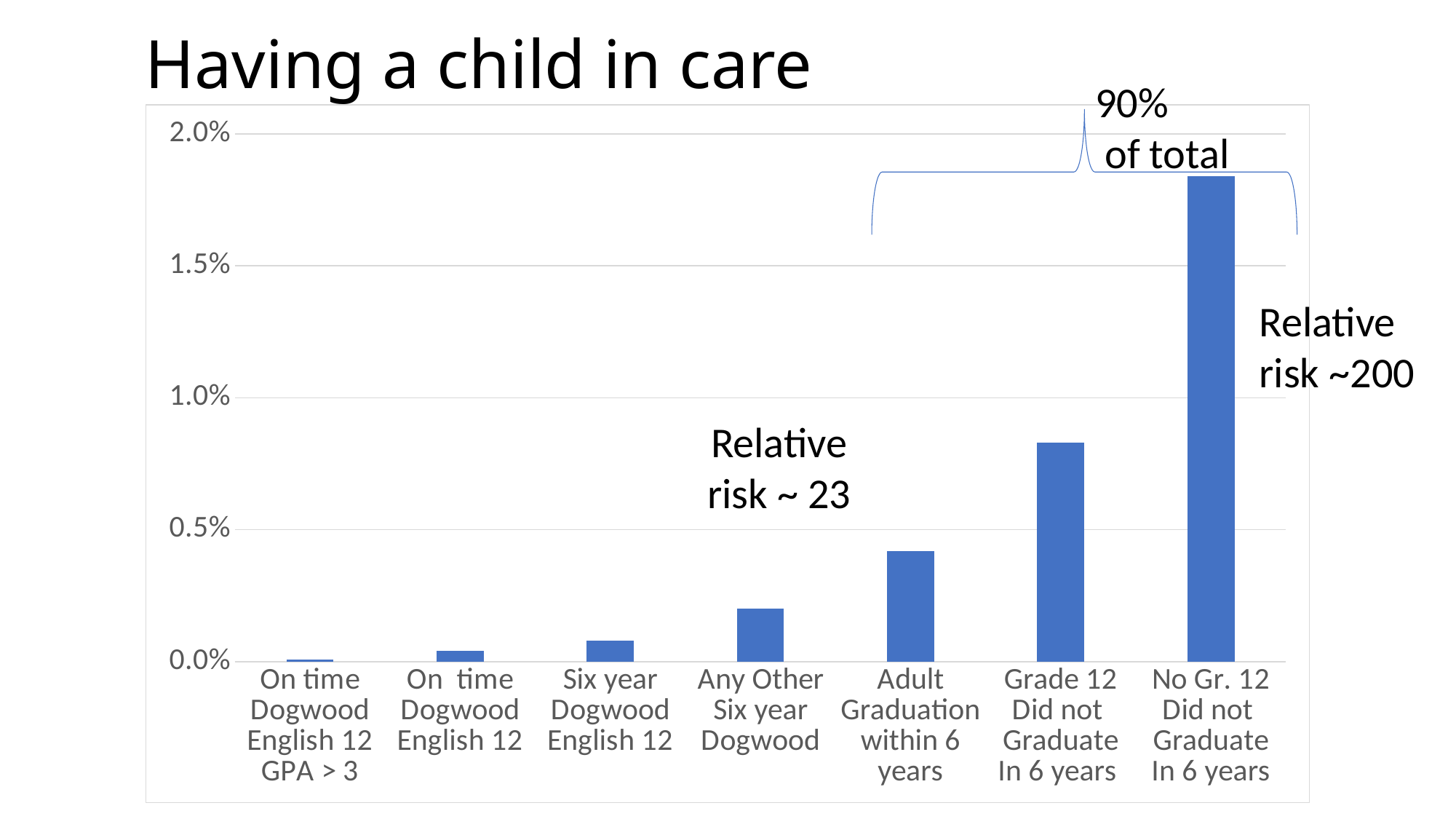
How many categories are plotted on the chart? 7 Is the value for Adult Graduation within 6 years greater or less than 0.5%? less Do the values rise or fall moving from left to right along the x axis? rise What kind of chart is shown on the slide? bar chart Which category has the highest value? No Gr. 12 Did not Graduate In 6 years Which is larger: the value for Six year Dogwood English 12 or the value for Any Other Six year Dogwood? Any Other Six year Dogwood Is the value for Grade 12 Did not Graduate In 6 years greater or less than 1.0%? less What is the title of the slide containing the chart? Having a child in care Which category has the lowest value? On time Dogwood English 12 GPA > 3 Which is larger: the value for Grade 12 Did not Graduate In 6 years or the value for Adult Graduation within 6 years? Grade 12 Did not Graduate In 6 years Is the value for No Gr. 12 Did not Graduate In 6 years greater or less than 1.5%? greater